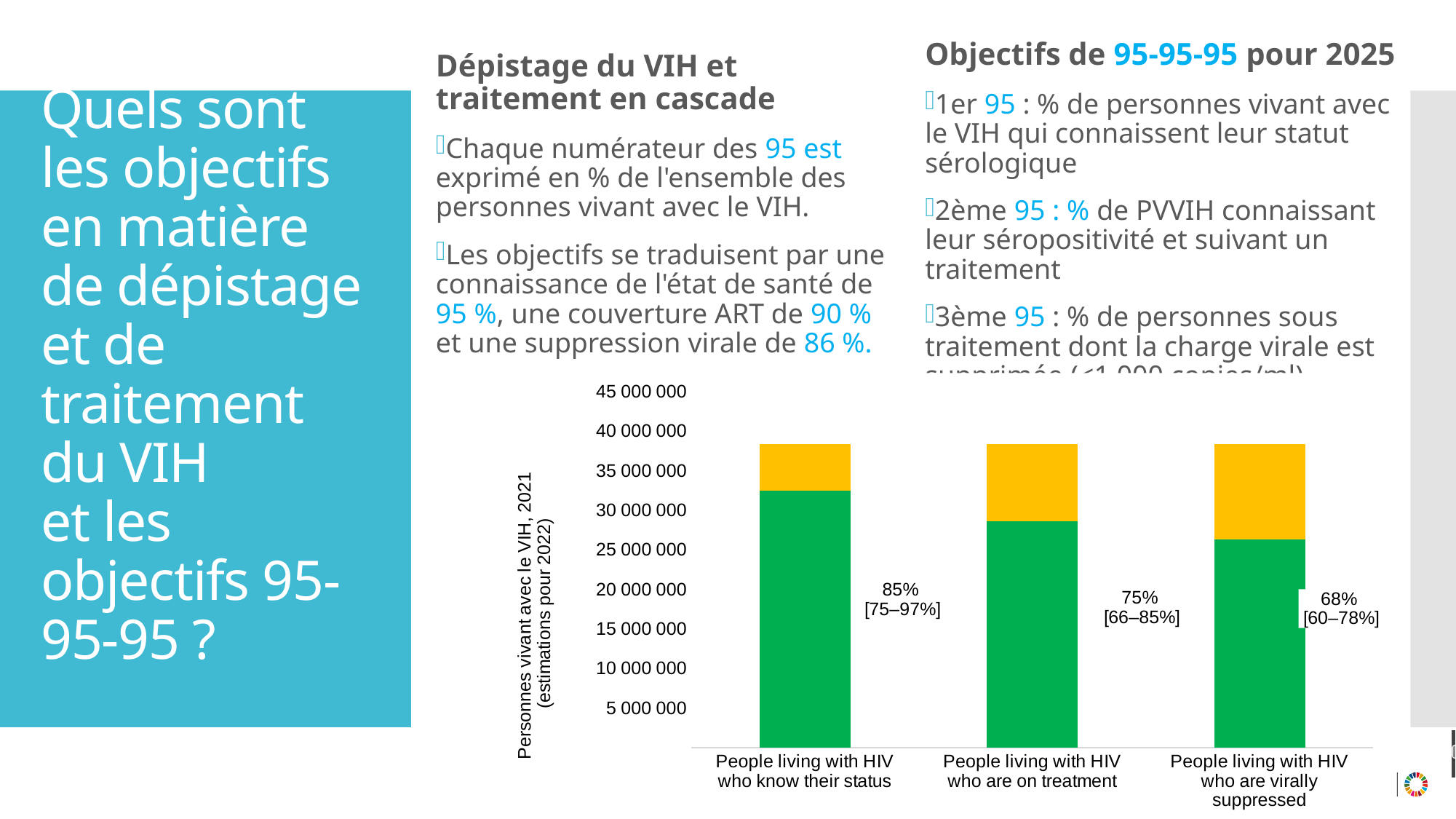
How many categories are shown on the x axis of the chart? 3 What percentage is labelled for 'People living with HIV who are virally suppressed'? 68% Which category has the lowest labelled percentage? People living with HIV who are virally suppressed What is the label on the vertical axis of the chart? Personnes vivant avec le VIH, 2021 (estimations pour 2022) Is the green portion of the bar for 'People living with HIV who know their status' greater or less than 30 000 000? greater What percentage is labelled for 'People living with HIV who are on treatment'? 75% Do the green portions of the bars rise or fall from left to right across the x axis? fall What percentage is labelled for 'People living with HIV who know their status'? 85% What is the difference in percentage points between the labels for 'People living with HIV who know their status' and 'People living with HIV who are on treatment'? 10 What kind of chart is shown on the slide? bar chart Which category has the highest labelled percentage? People living with HIV who know their status What is the range shown in brackets for 'People living with HIV who are virally suppressed'? [60–78%]